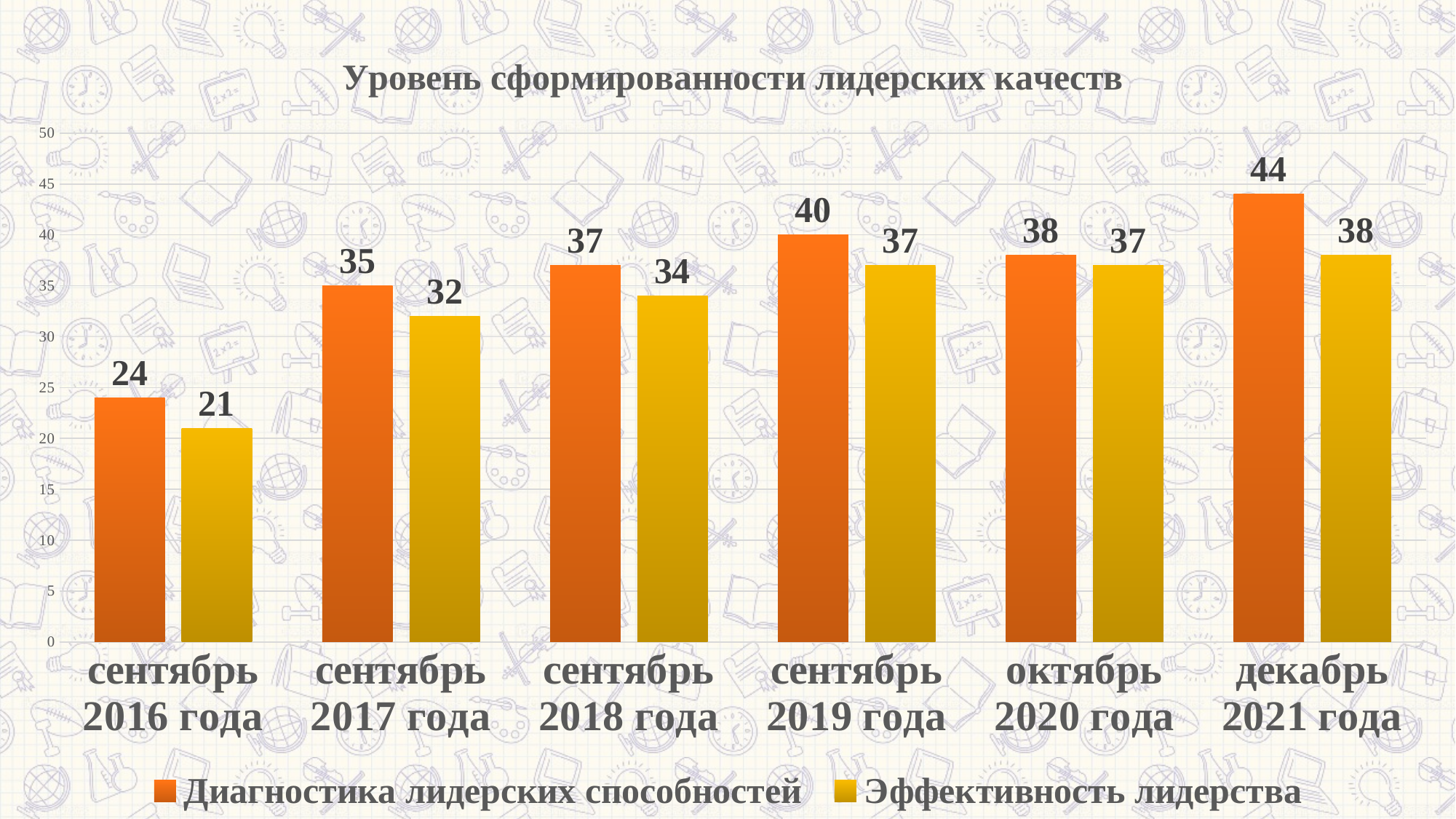
What is the difference between «Диагностика лидерских способностей» and «Эффективность лидерства» for сентябрь 2019 года? 3 How many periods are shown on the x axis? 6 What is the title of the chart? Уровень сформированности лидерских качеств Which period has the highest value for «Эффективность лидерства»? декабрь 2021 года What is the value of «Диагностика лидерских способностей» for декабрь 2021 года? 44 What is the value of «Диагностика лидерских способностей» for сентябрь 2016 года? 24 What kind of chart is shown on the slide? Bar chart Which period has the lowest value for «Диагностика лидерских способностей»? сентябрь 2016 года Does the value of «Диагностика лидерских способностей» rise or fall from сентябрь 2016 года to декабрь 2021 года? Rise Which is larger for сентябрь 2017 года: «Диагностика лидерских способностей» or «Эффективность лидерства»? Диагностика лидерских способностей What is the value of «Эффективность лидерства» for сентябрь 2018 года? 34 How many series does the legend list? 2